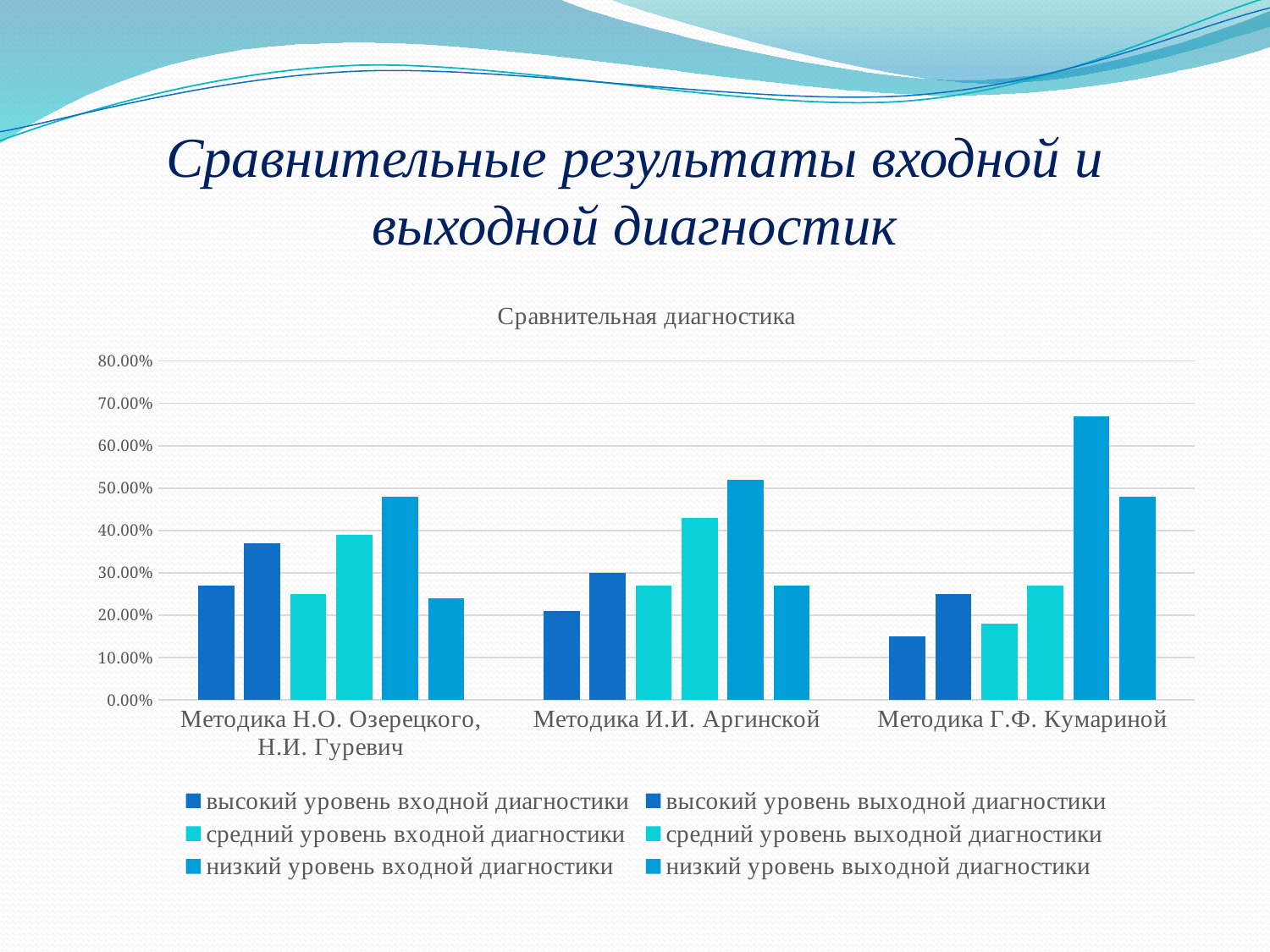
For Методика Н.О. Озерецкого, Н.И. Гуревич, which is larger: низкий уровень входной диагностики or низкий уровень выходной диагностики? низкий уровень входной диагностики What kind of chart is shown on the slide? bar chart What is the title of the chart? Сравнительная диагностика Which methodology has the highest value for низкий уровень входной диагностики? Методика Г.Ф. Кумариной How many methodology categories are shown on the x axis of the chart? 3 What is the highest value shown on the vertical axis of the chart? 80.00% Is the value for низкий уровень входной диагностики in Методика Г.Ф. Кумариной greater or less than 60%? greater For Методика И.И. Аргинской, which is larger: средний уровень входной диагностики or средний уровень выходной диагностики? средний уровень выходной диагностики Is the value for низкий уровень входной диагностики in Методика И.И. Аргинской greater or less than 40%? greater How many series does the chart legend list? 6 Which methodology has the lowest value for высокий уровень входной диагностики? Методика Г.Ф. Кумариной Is the value for высокий уровень входной диагностики in Методика Г.Ф. Кумариной greater or less than 20%? less